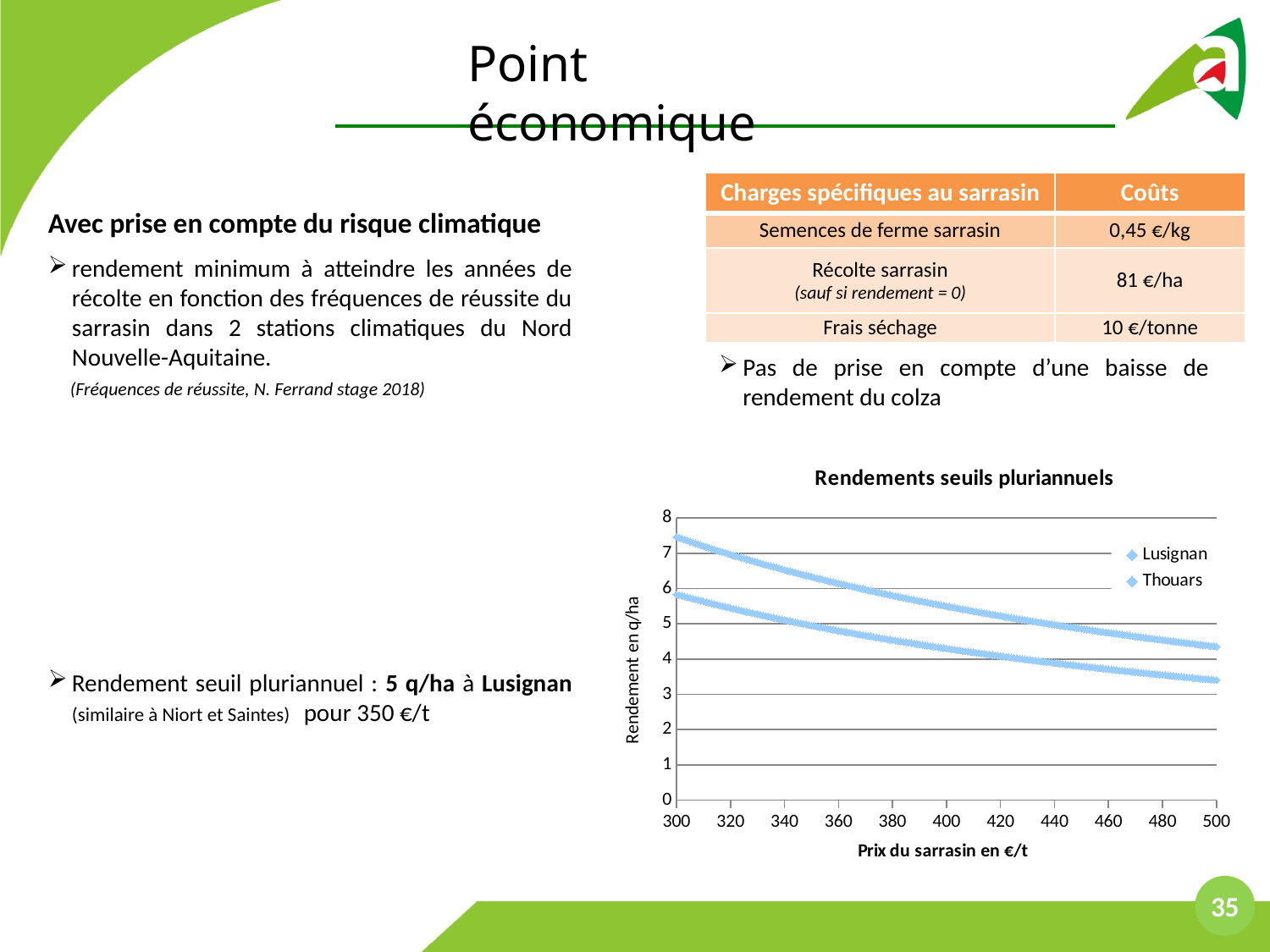
What kind of chart is shown on the slide? scatter chart How many series does the legend of the chart list? 2 What is the label of the x axis of the chart? Prix du sarrasin en €/t Is the value of the lower series at 500 €/t greater or less than 4? less Do the plotted values rise or fall as the price of buckwheat increases along the x axis? fall At which price on the x axis do the plotted series reach their lowest values? 500 Is the value of the upper series at 500 €/t greater or less than 5? less Is the value of the lower series at 300 €/t greater or less than 5? greater Which series are listed in the chart's legend? Lusignan and Thouars At which price on the x axis do the plotted series reach their highest values? 300 What is the title of the chart on the slide? Rendements seuils pluriannuels